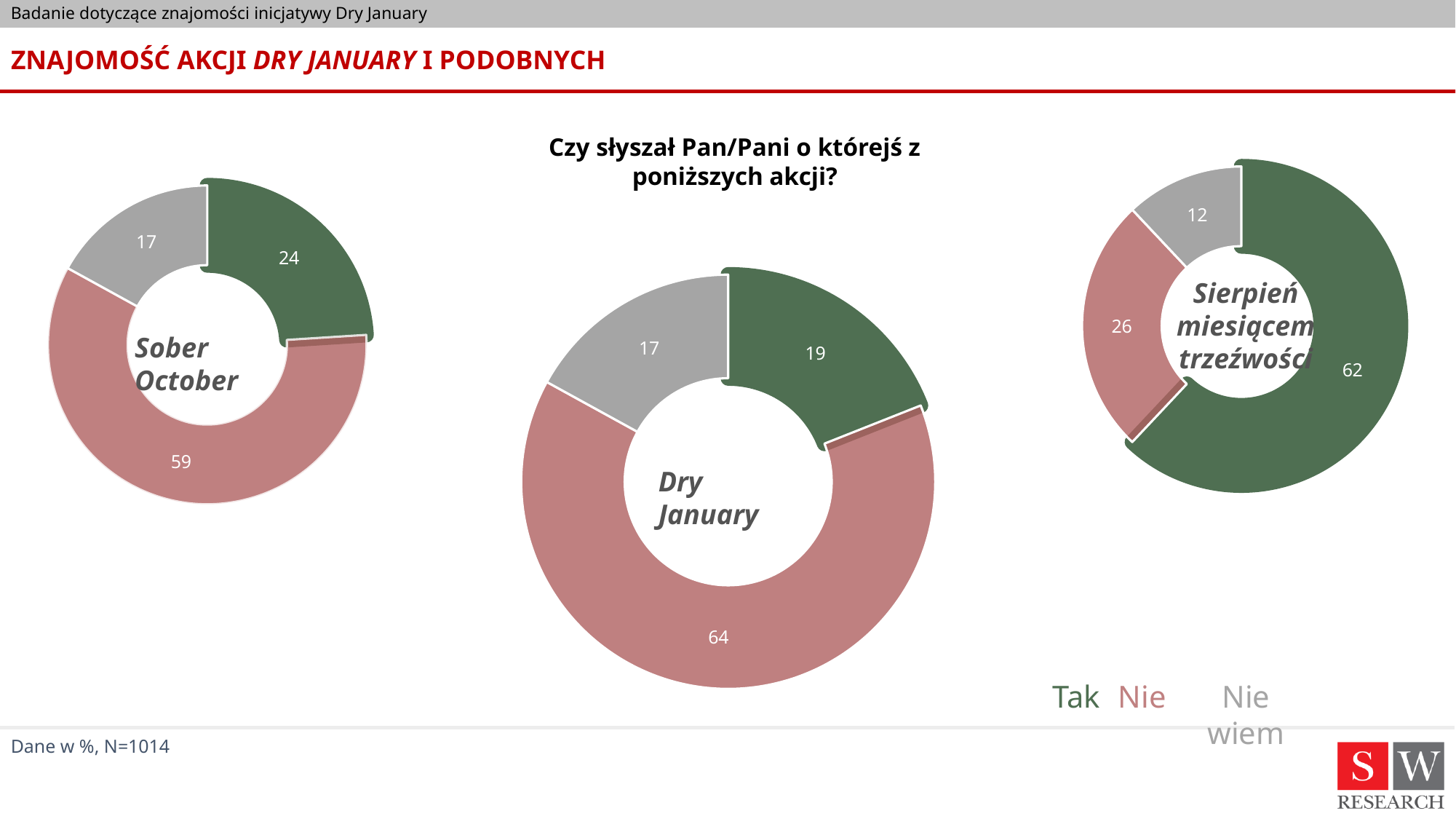
In the Sober October chart, what is the value for "Tak"? 24 In the Dry January chart, what is the value for "Nie"? 64 In the Sierpień miesiącem trzeźwości chart, which category has the smallest share? Nie wiem In the Sober October chart, what is the difference between the "Nie" and "Tak" values? 35 Which colour represents "Nie wiem" in the legend? Grey What kind of chart is the Sober October chart? Donut (pie) chart In the Sierpień miesiącem trzeźwości chart, what is the total of the three slices? 100 In the Dry January chart, which category has the largest share? Nie How many entries does the legend list? 3 In the Sierpień miesiącem trzeźwości chart, what is the value for "Nie wiem"? 12 How many slices does the Dry January chart have? 3 Which is larger: the "Tak" value in the Sierpień miesiącem trzeźwości chart or the "Tak" value in the Dry January chart? Sierpień miesiącem trzeźwości